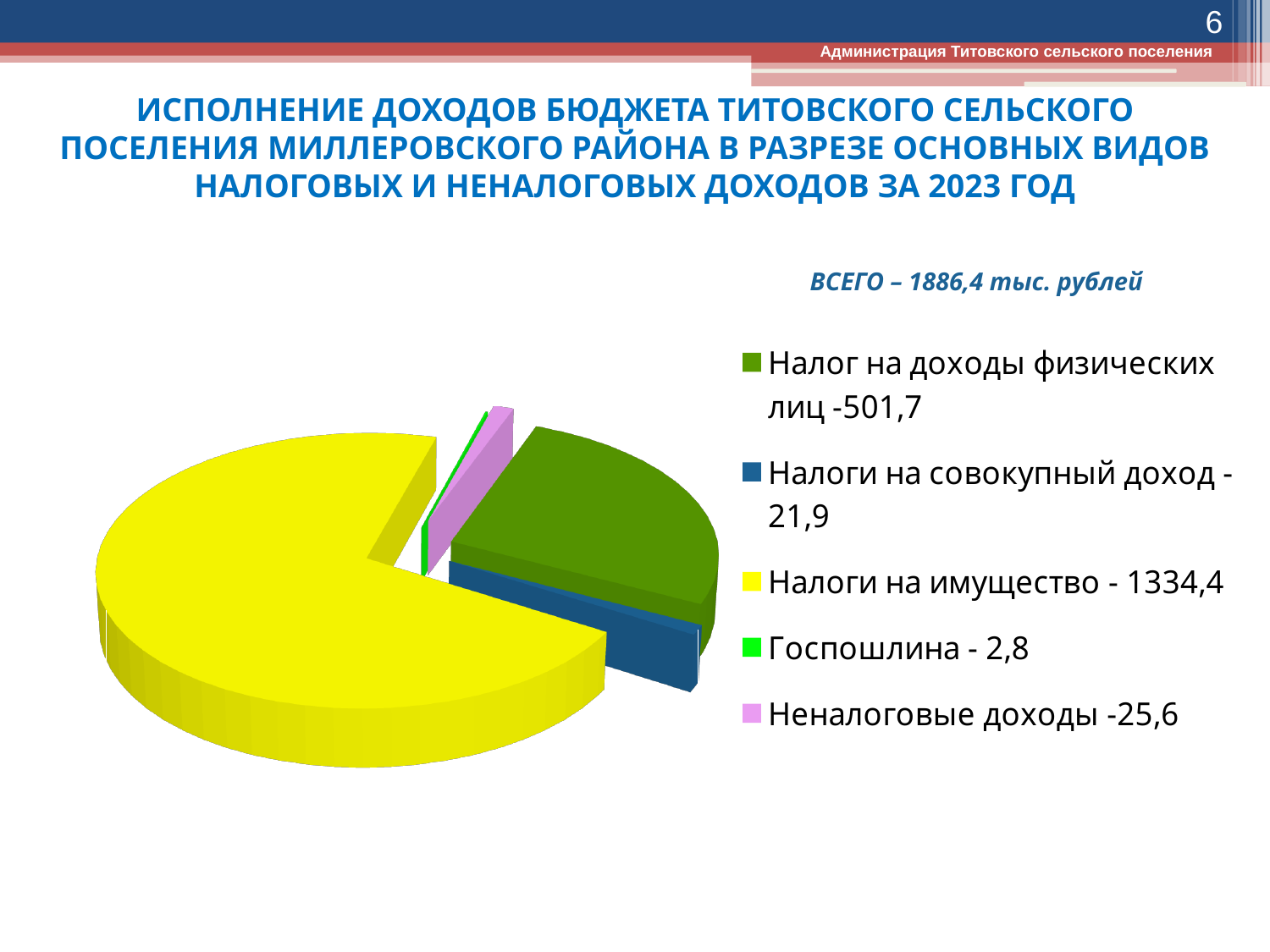
What is the value for Налоги на имущество? 1334,4 What is the value for Госпошлина? 2,8 What kind of chart is shown on the slide? pie chart What is the value for Налог на доходы физических лиц? 501,7 Which category has the largest value? Налоги на имущество Which is larger: Налоги на совокупный доход or Неналоговые доходы? Неналоговые доходы Which category has the smallest value? Госпошлина How many categories does the pie chart show? 5 What is the value for Неналоговые доходы? 25,6 What is the difference between Неналоговые доходы and Налоги на совокупный доход? 3,7 What total amount (ВСЕГО) is stated on the slide? 1886,4 тыс. рублей What is the difference between Налоги на имущество and Налог на доходы физических лиц? 832,7